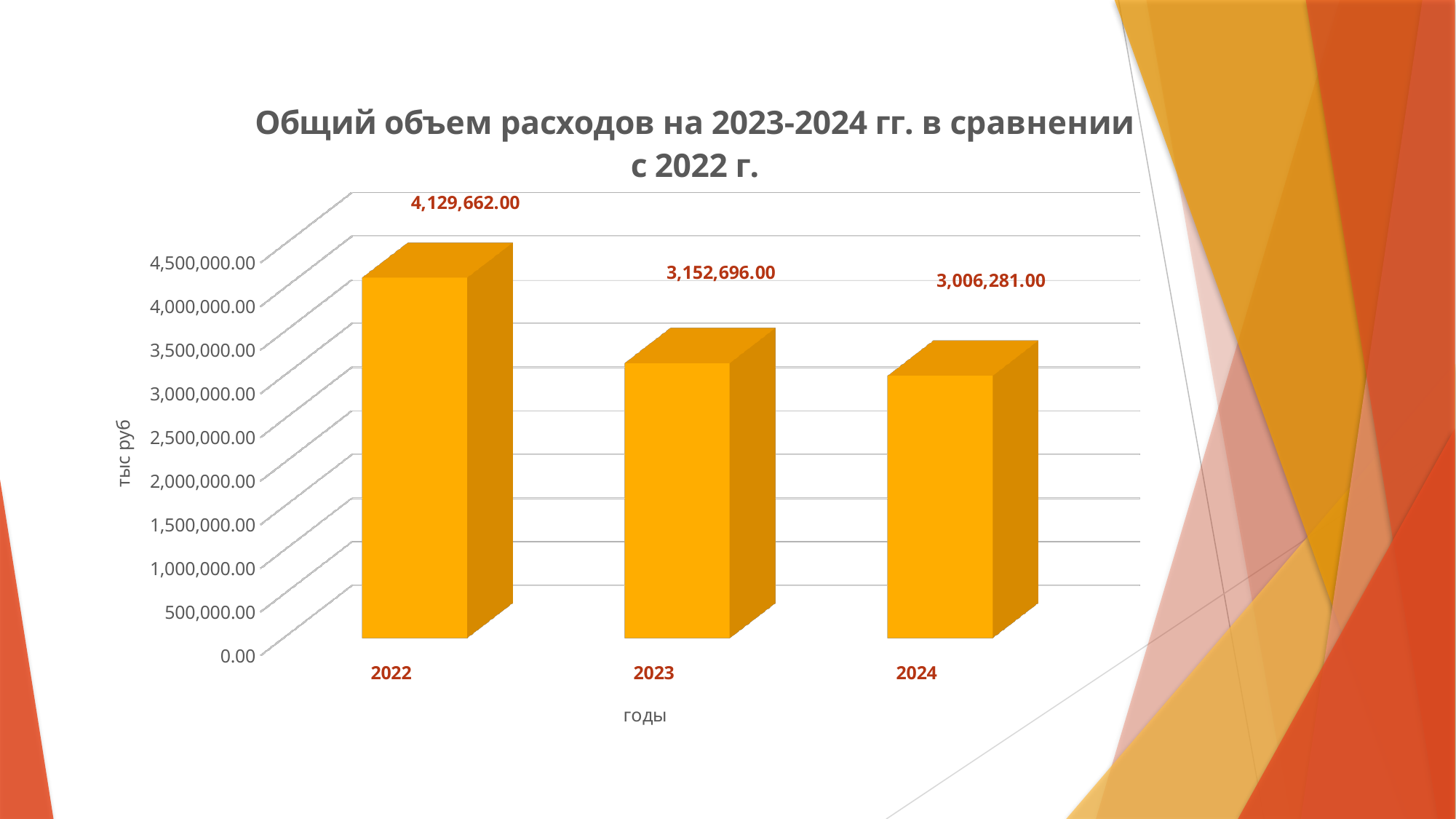
What is the difference between the values for 2022 and 2023? 976,966.00 What is the value for 2022? 4,129,662.00 Which year has the highest value? 2022 Which is larger, the value for 2022 or the value for 2024? 2022 Do the values rise or fall from 2022 to 2024? fall What kind of chart is this? bar chart What is the value for 2024? 3,006,281.00 What is the difference between the values for 2023 and 2024? 146,415.00 Which year has the lowest value? 2024 How many years are shown on the x axis? 3 Is the value for 2023 greater or less than 3,000,000.00? greater What is the value for 2023? 3,152,696.00